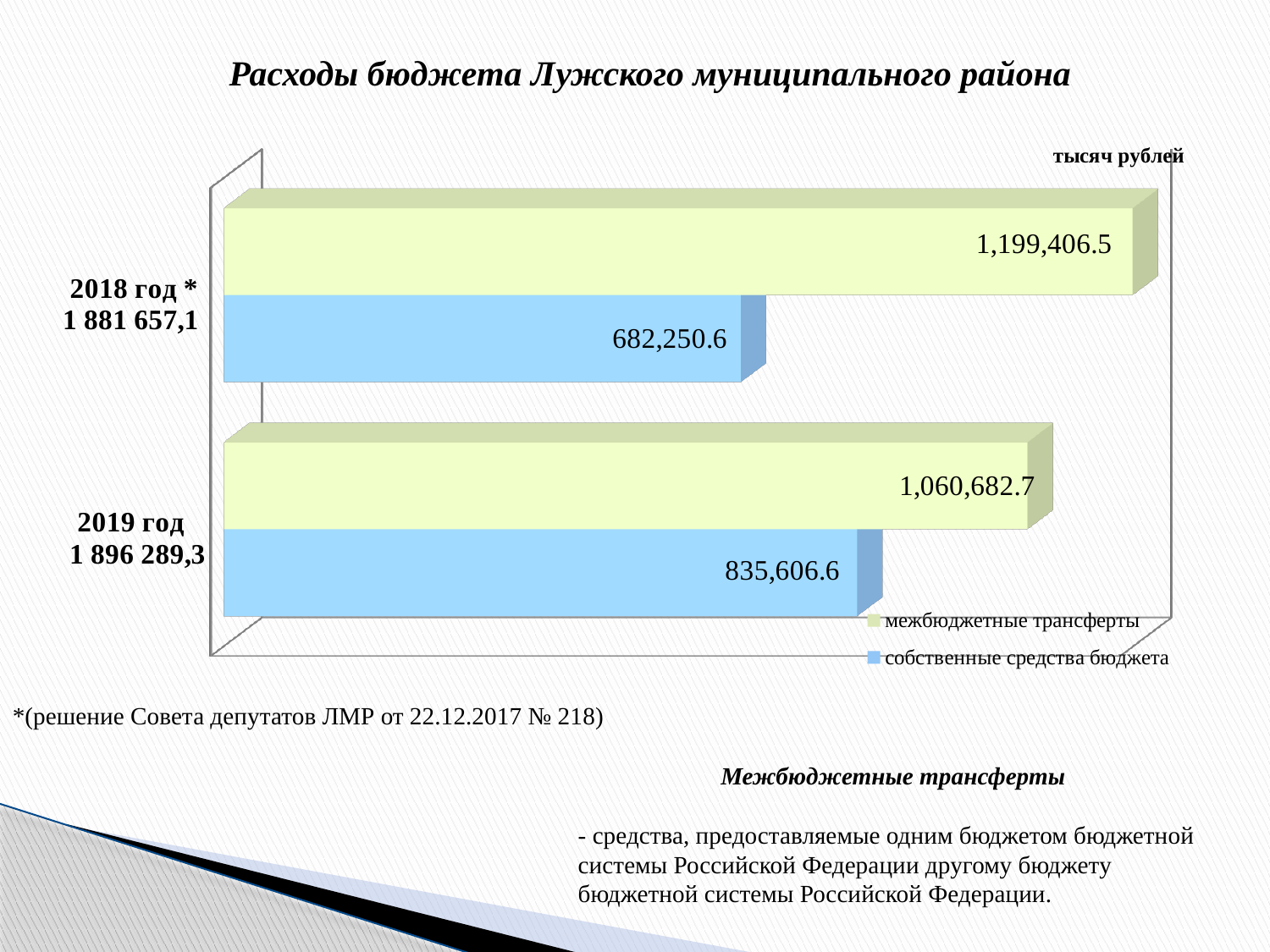
What is the difference between межбюджетные трансферты and собственные средства бюджета in 2018 год? 517,155.9 What is the value of межбюджетные трансферты for 2019 год? 1,060,682.7 How many series does the legend list? 2 What is the value of собственные средства бюджета for 2018 год? 682,250.6 Which year has the higher value for межбюджетные трансферты? 2018 год What kind of chart is shown on the slide? bar chart What is the value of межбюджетные трансферты for 2018 год? 1,199,406.5 By how much did собственные средства бюджета change from 2018 год to 2019 год? 153,356.0 In 2019 год, which is larger: межбюджетные трансферты or собственные средства бюджета? межбюджетные трансферты Which year has the lower value for собственные средства бюджета? 2018 год What unit is stated for the chart values? тысяч рублей What is the value of собственные средства бюджета for 2019 год? 835,606.6